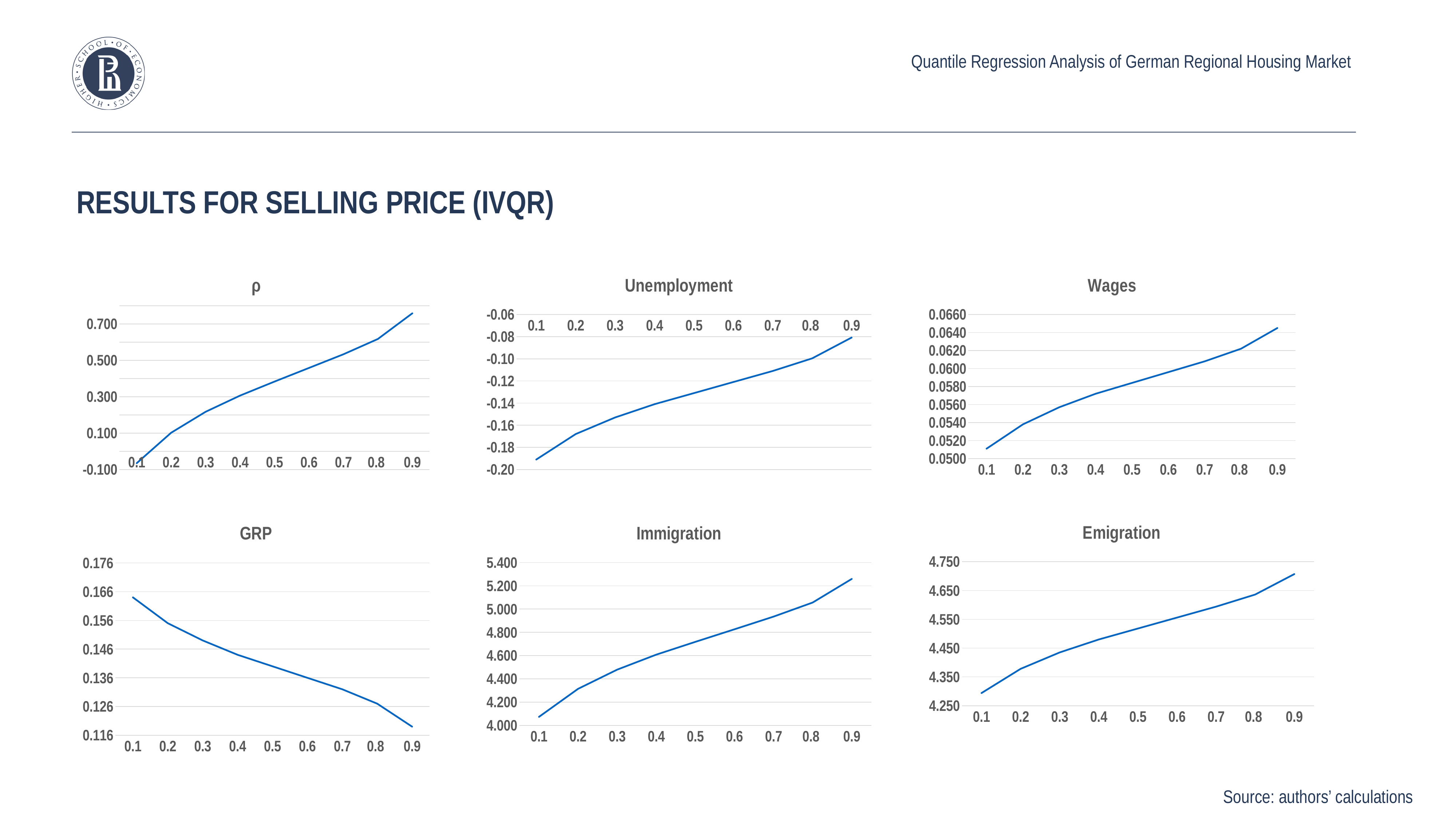
In the ρ chart, is the value at quantile 0.9 greater or less than 0.700? greater In the Unemployment chart, do the values rise or fall as the quantile increases from 0.1 to 0.9? rise In the GRP chart, at which quantile is the value lowest? 0.9 In the Wages chart, at which quantile is the value highest? 0.9 In the GRP chart, which quantile has the larger value, 0.2 or 0.8? 0.2 How many charts are shown on the slide? 6 In the Immigration chart, how many quantile points are plotted along the x axis? 9 In the Immigration chart, is the value at quantile 0.9 greater or less than 5.200? greater In the Emigration chart, is the value at quantile 0.1 greater or less than 4.350? less What kind of chart is the GRP chart? line chart In the GRP chart, do the values rise or fall as the quantile increases from 0.1 to 0.9? fall